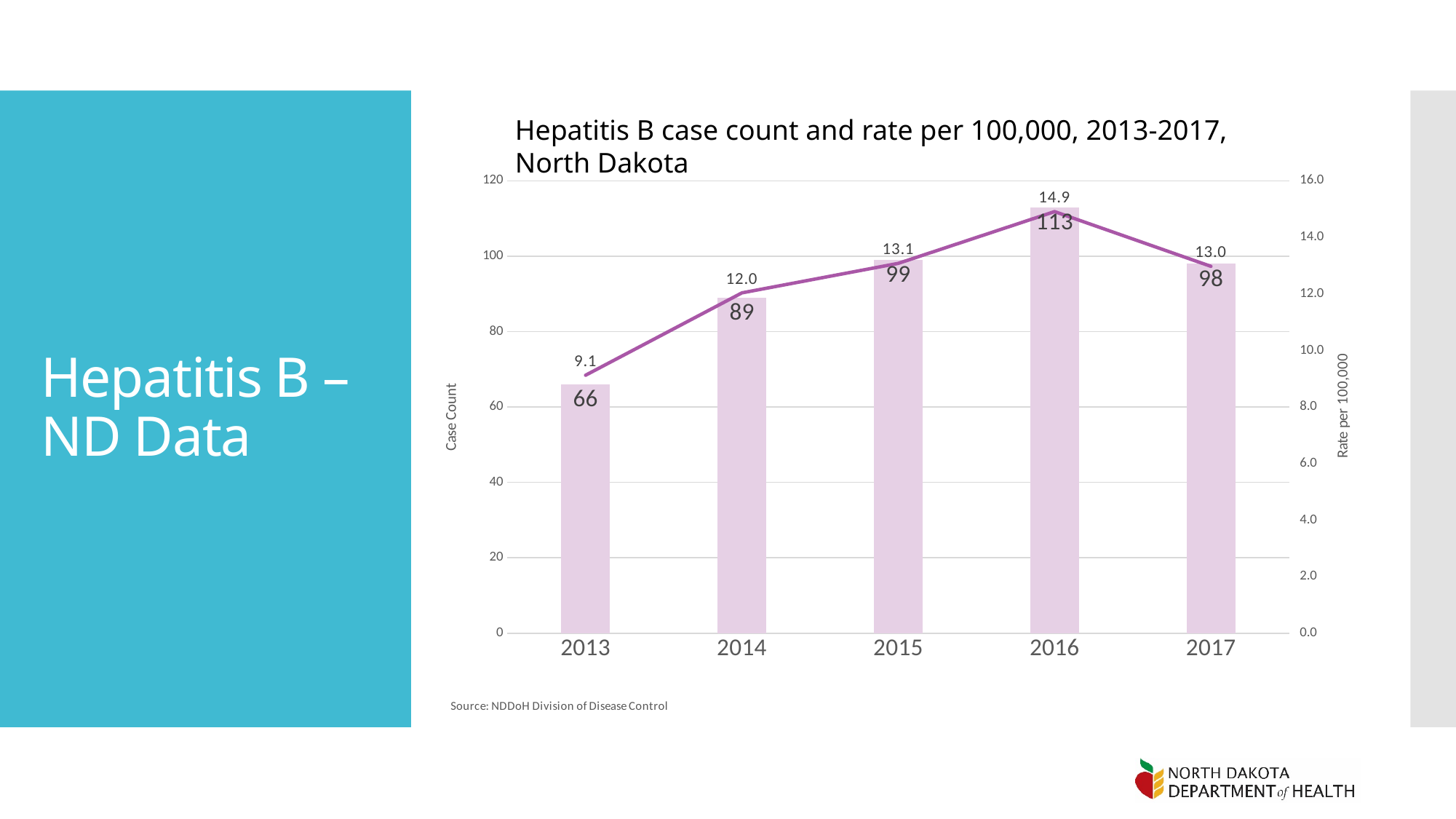
Which year had a higher case count, 2015 or 2017? 2015 What was the Hepatitis B rate per 100,000 in 2017? 13.0 How many years are shown on the x axis of the chart? 5 What was the Hepatitis B case count in 2014? 89 What was the Hepatitis B case count in North Dakota in 2016? 113 Which year had the lowest Hepatitis B rate per 100,000? 2013 What is the label of the right-hand vertical axis? Rate per 100,000 What is the difference in case count between 2016 and 2013? 47 Which year had the highest Hepatitis B case count? 2016 What was the Hepatitis B rate per 100,000 in 2013? 9.1 What kind of chart is used to show the case count? Bar chart Did the Hepatitis B case count rise or fall from 2013 to 2016? Rise